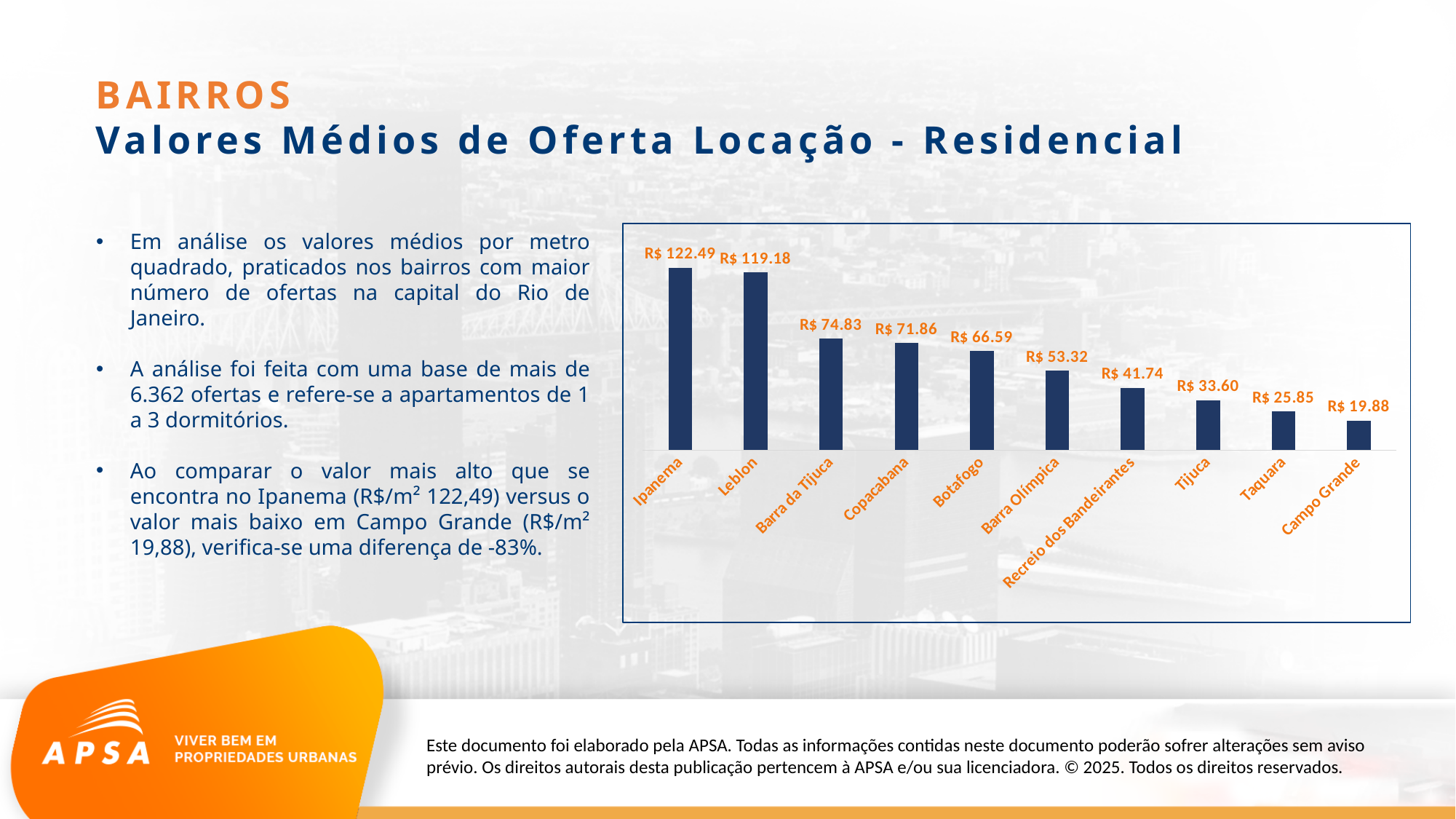
Which bairro has the lowest value in the chart? Campo Grande Which has a higher value, Botafogo or Barra Olímpica? Botafogo What is the value shown for Copacabana? R$ 71.86 How many bairros are shown in the chart? 10 What is the value shown for Taquara? R$ 25.85 Which bairro has the highest value in the chart? Ipanema What is the difference between the values for Ipanema and Leblon? R$ 3.31 What kind of chart is shown on the slide? Bar chart What is the value shown for Ipanema? R$ 122.49 What is the value shown for Recreio dos Bandeirantes? R$ 41.74 Do the values rise or fall from left to right across the chart? Fall What is the difference between the values for Ipanema and Campo Grande? R$ 102.61